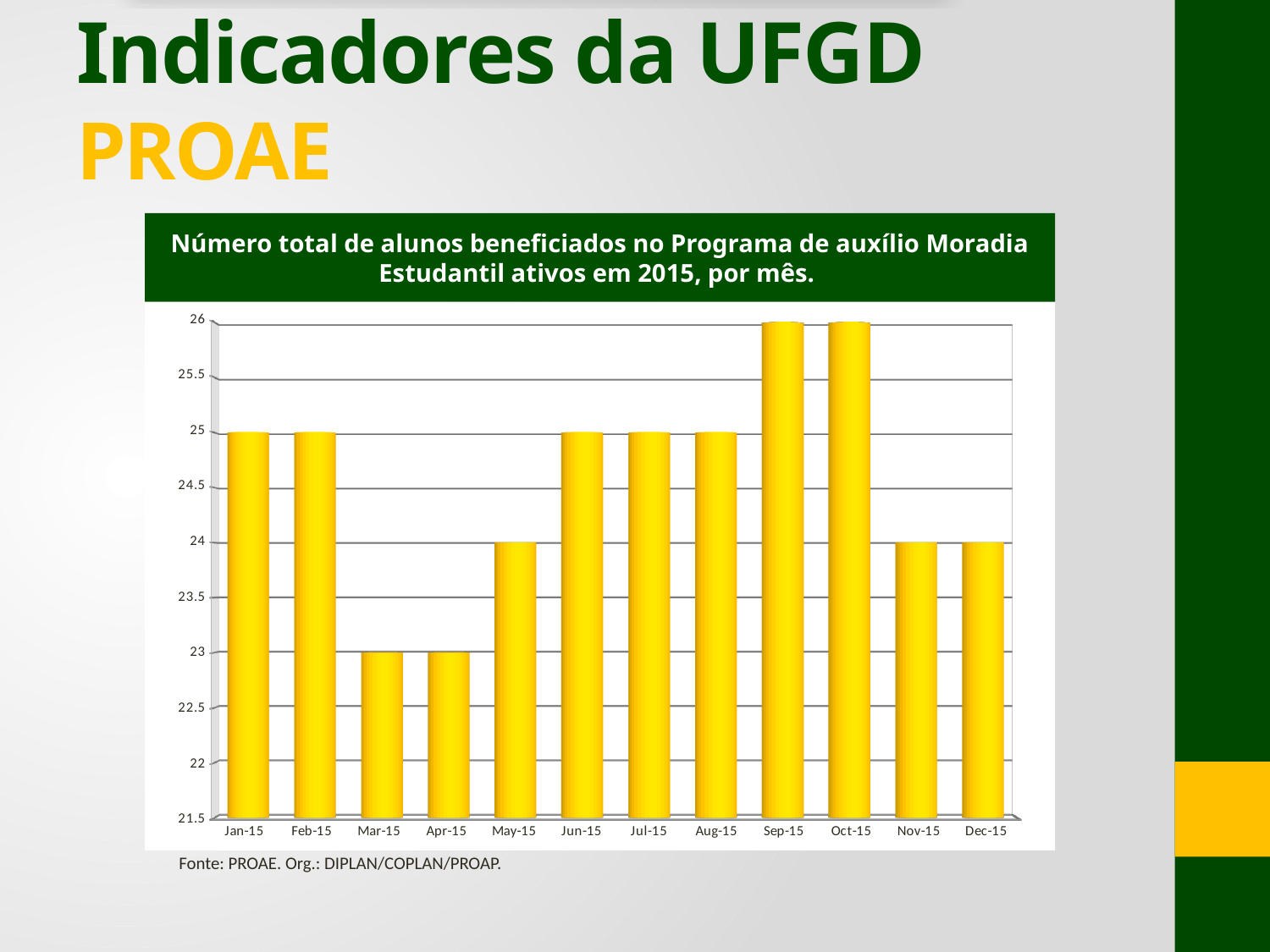
What is the value for Jan-15? 25 How many months are shown on the x axis of the chart? 12 What is the value for Sep-15? 26 What is the value for May-15? 24 What is the difference between the values for Oct-15 and Nov-15? 2 Which months have the highest value? Sep-15 and Oct-15 What is the title of the chart? Número total de alunos beneficiados no Programa de auxílio Moradia Estudantil ativos em 2015, por mês. Which months have the lowest value? Mar-15 and Apr-15 Is the value for Dec-15 greater or less than 25? less What is the value for Mar-15? 23 Which is larger, the value for Feb-15 or the value for Apr-15? Feb-15 What type of chart is shown on the slide? bar chart